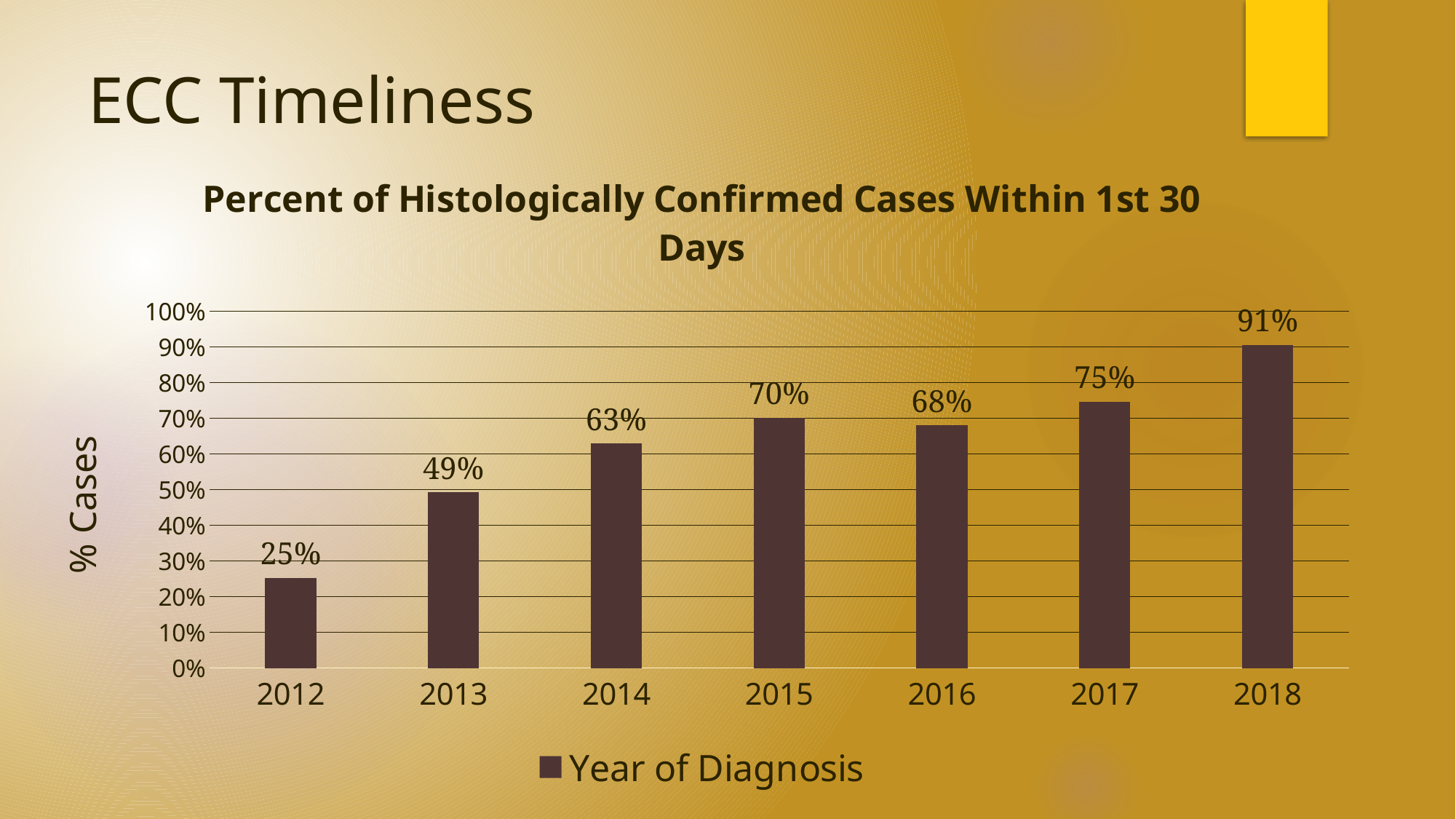
What kind of chart is shown? bar chart Which year has the highest value? 2018 Is the value for 2013 greater or less than 50%? less What is the value for 2012? 25% What is the value for 2016? 68% How many years are shown on the x axis? 7 Which is larger, the value for 2015 or the value for 2016? 2015 What is the label on the y axis? % Cases What is the value for 2018? 91% Which year has the lowest value? 2012 What is the difference between the values for 2017 and 2016? 7% What is the difference between the values for 2018 and 2012? 66%